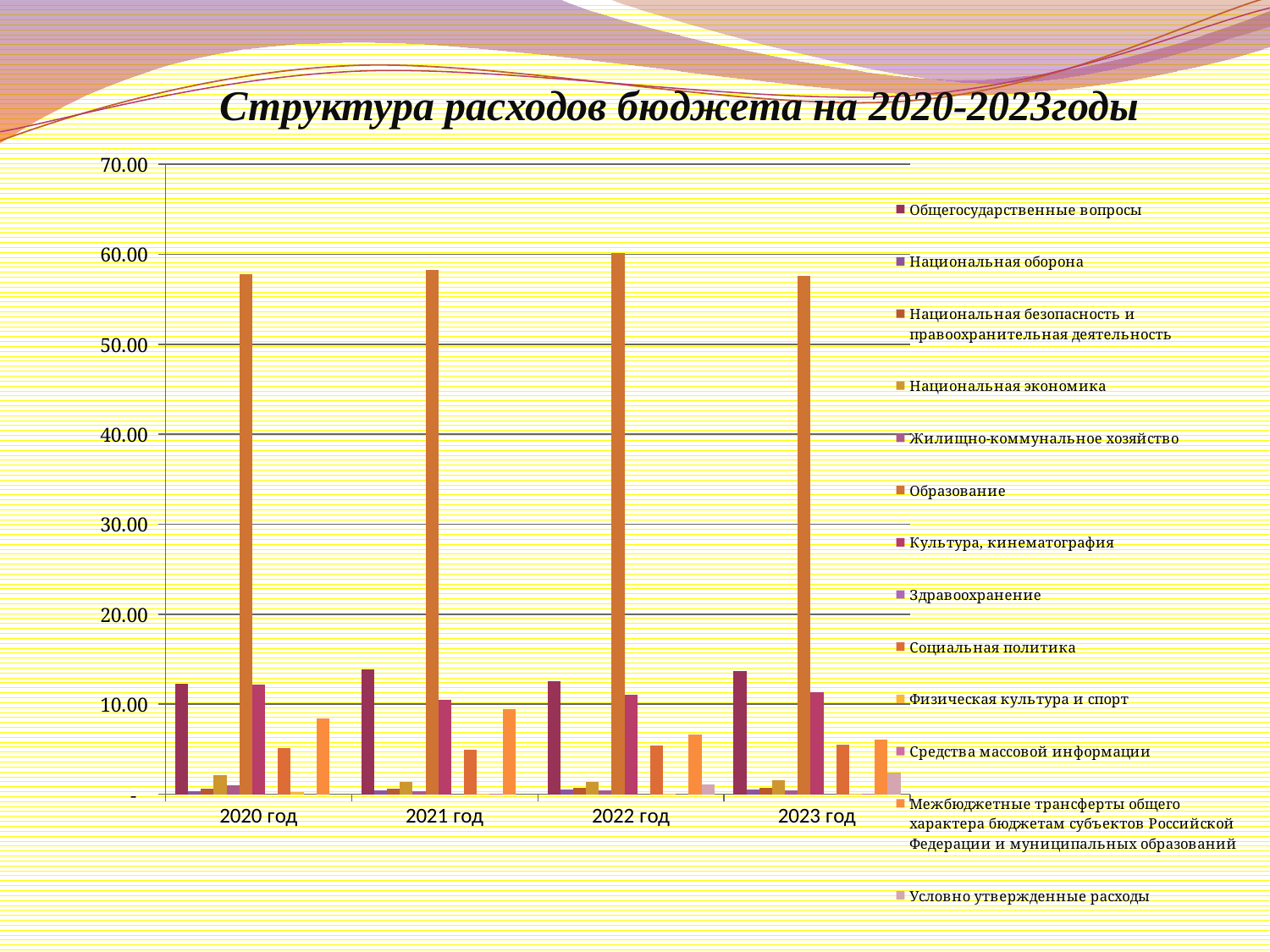
How many series does the legend list? 13 Is the value for Культура, кинематография in 2020 год greater or less than 10? greater What is the highest value shown on the vertical axis? 70.00 Which series has the tallest bar in every year? Образование How many year categories are shown on the x axis? 4 Is the value for Социальная политика in 2020 год greater or less than 10? less Is the value for Образование in 2020 год greater or less than 50? greater In 2022 год, which is larger: Социальная политика or Межбюджетные трансферты общего характера бюджетам субъектов Российской Федерации и муниципальных образований? Межбюджетные трансферты общего характера бюджетам субъектов Российской Федерации и муниципальных образований What is the title of the chart? Структура расходов бюджета на 2020-2023годы In 2023 год, which is larger: Образование or Общегосударственные вопросы? Образование What kind of chart is shown on the slide? bar chart